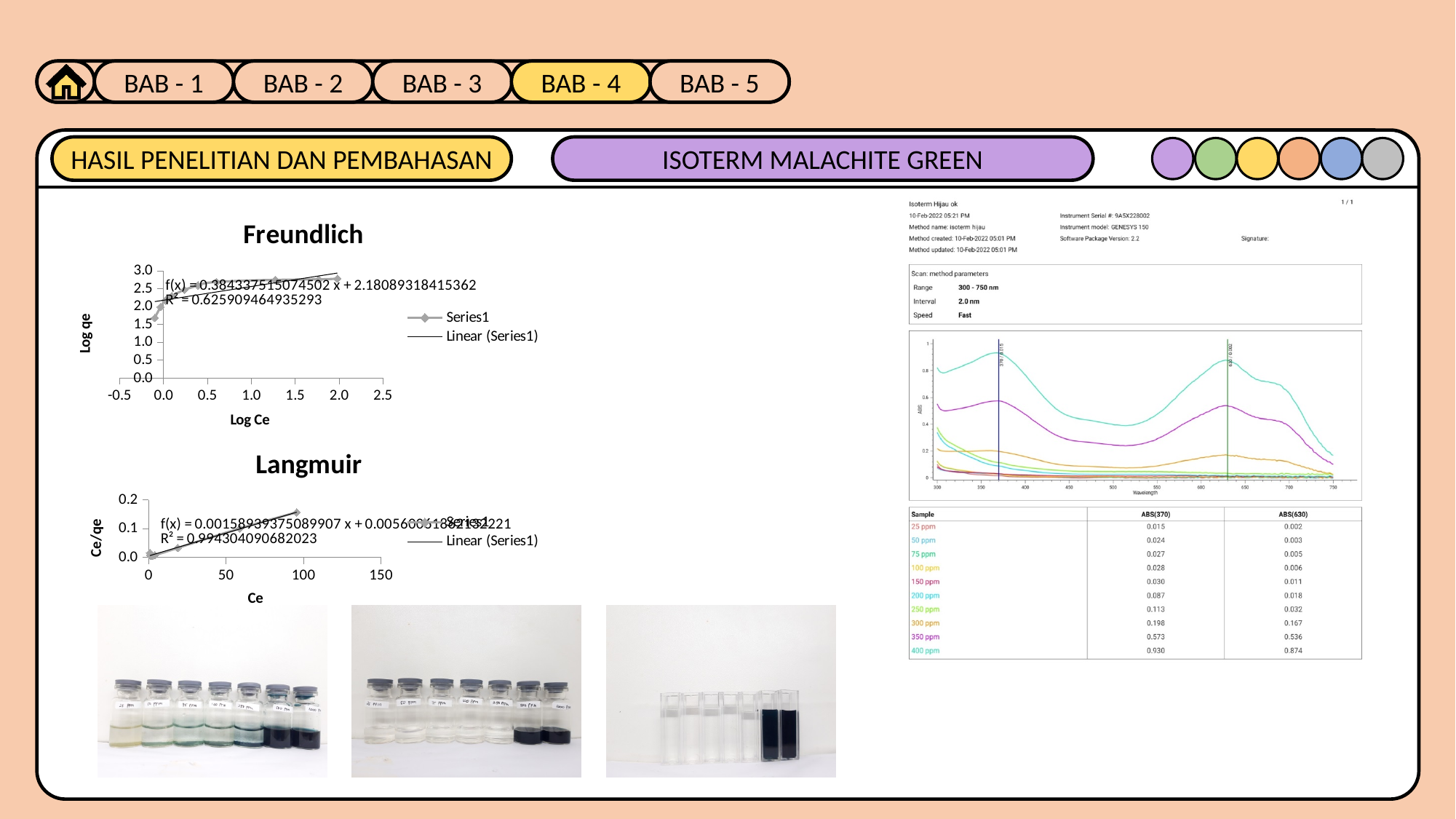
What R² value is shown on the Freundlich chart? 0.625909464935293 What is the slope of the trendline equation on the Langmuir chart? 0.00158939375089907 In the Langmuir chart, is the Ce/qe value of the rightmost point greater or less than 0.1? greater In the Langmuir chart, do the Ce/qe values rise or fall as Ce increases? rise What is the slope of the trendline equation on the Freundlich chart? 0.384337515074502 What is the intercept of the trendline equation on the Freundlich chart? 2.18089318415362 What R² value is shown on the Langmuir chart? 0.994304090682023 How many series does the legend of the Freundlich chart list? 2 What is the y-axis title of the Langmuir chart? Ce/qe What kind of chart is the Freundlich chart? scatter chart Which chart shows the higher R² value, Freundlich or Langmuir? Langmuir What is the x-axis title of the Freundlich chart? Log Ce